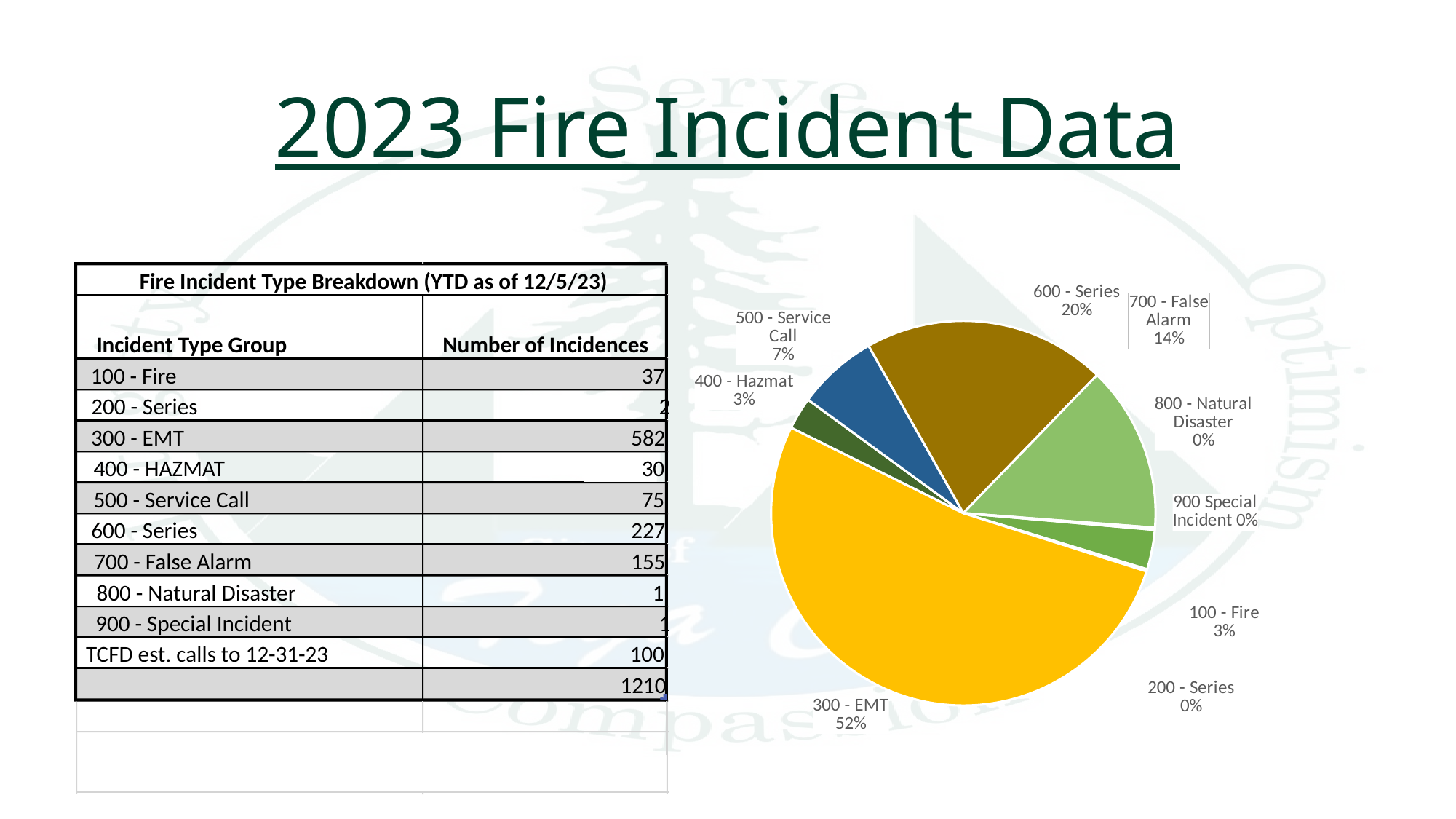
What percentage is shown for 700 - False Alarm in the pie chart? 14% What kind of chart is shown on the slide? pie chart Which category has the largest slice of the pie chart? 300 - EMT What is the difference in percentage points between the 300 - EMT slice and the 600 - Series slice? 32 What percentage is shown for 500 - Service Call in the pie chart? 7% What percentage is shown for 100 - Fire in the pie chart? 3% Which slice is larger in the pie chart, 600 - Series or 700 - False Alarm? 600 - Series What percentage is shown for 600 - Series in the pie chart? 20% What percentage is shown for 800 - Natural Disaster in the pie chart? 0% What share of the pie does 300 - EMT represent? 52% How many categories are labelled in the pie chart? 9 What percentage is shown for 400 - Hazmat in the pie chart? 3%